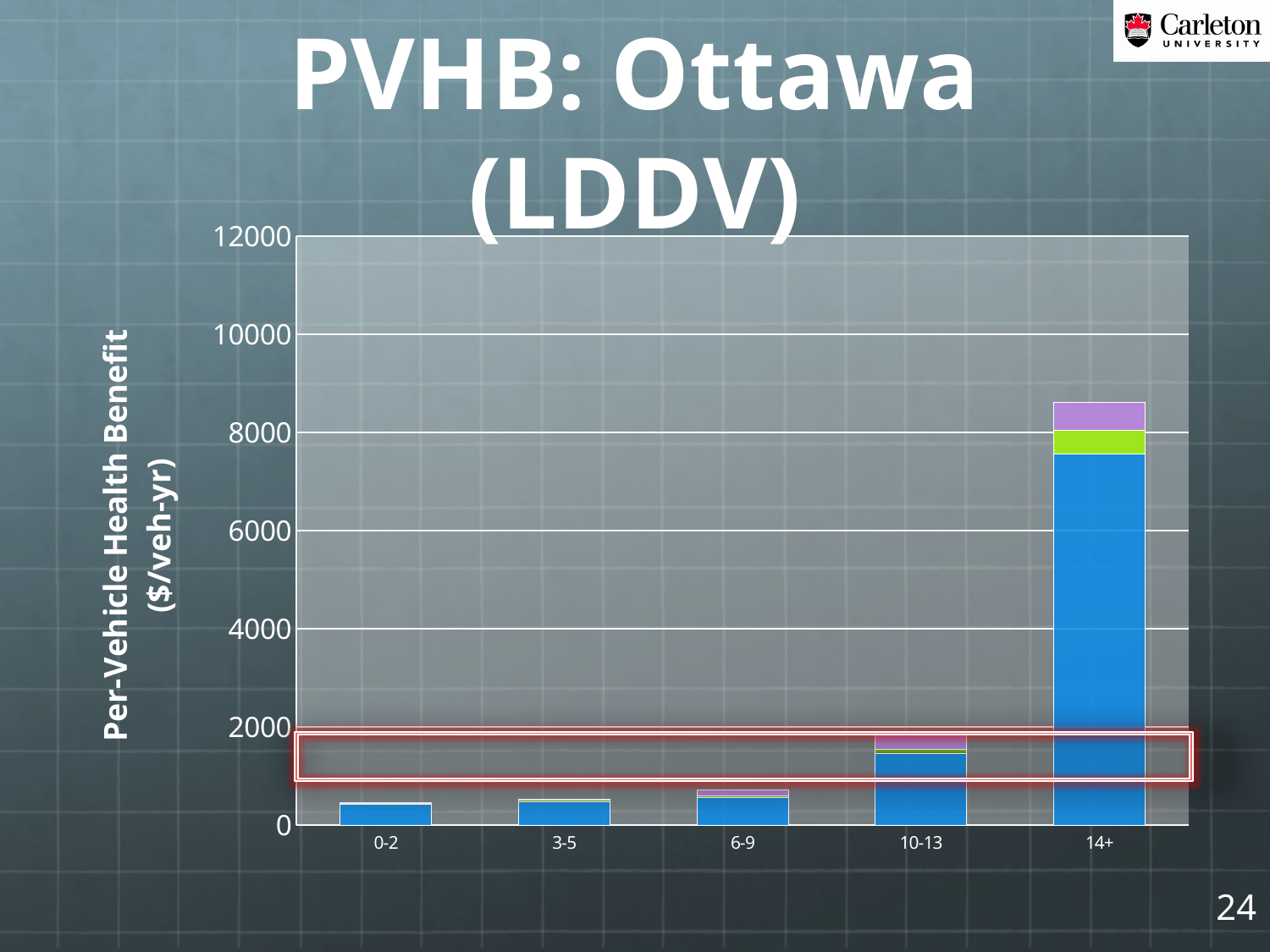
What is the label of the y axis? Per-Vehicle Health Benefit ($/veh-yr) How many vehicle age categories are shown on the x axis? 5 Is the total value for the 10-13 category greater or less than 1000? greater What kind of chart is shown on the slide? bar chart Which category has the larger total, 10-13 or 14+? 14+ Do the bar totals rise or fall as the vehicle age categories increase along the x axis? rise Is the total value for the 14+ category greater or less than 8000? greater Which category has the larger total, 6-9 or 10-13? 10-13 Is the total value for the 6-9 category greater or less than 2000? less Which category has the highest total per-vehicle health benefit? 14+